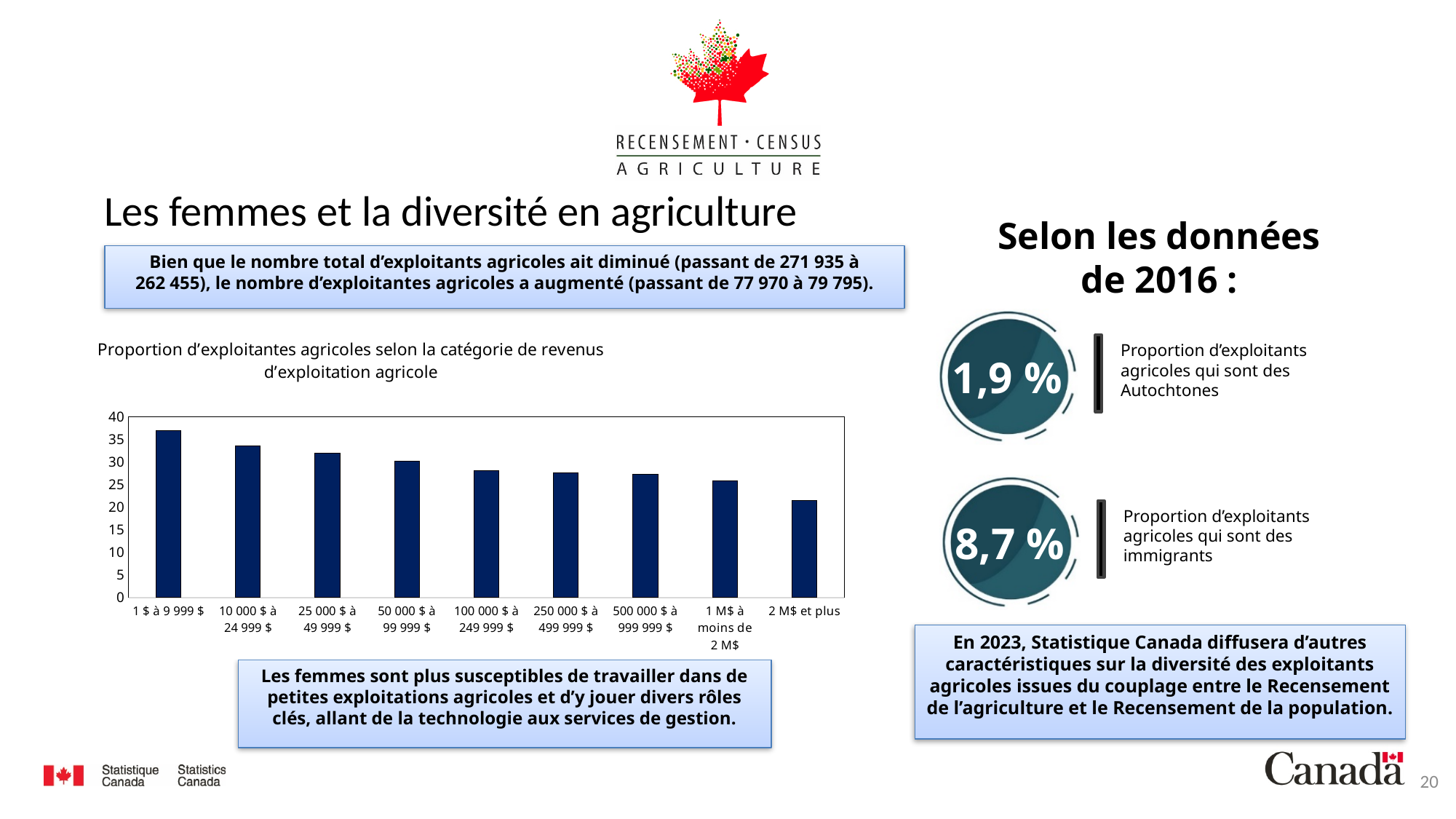
Which revenue category has the highest proportion of female farm operators? 1 $ à 9 999 $ Is the value for 25 000 $ à 49 999 $ greater or less than 30? greater What is the maximum value shown on the chart's vertical axis? 40 Is the value for 1 $ à 9 999 $ greater or less than 35? greater What kind of chart is shown on the slide? bar chart Is the value for 2 M$ et plus greater or less than 25? less What is the title of the chart? Proportion d'exploitantes agricoles selon la catégorie de revenus d'exploitation agricole How many revenue categories are shown on the x axis of the chart? 9 Which is larger, the value for 10 000 $ à 24 999 $ or the value for 1 M$ à moins de 2 M$? 10 000 $ à 24 999 $ Which revenue category has the lowest proportion of female farm operators? 2 M$ et plus Do the values rise or fall as you move from left to right along the x axis? fall